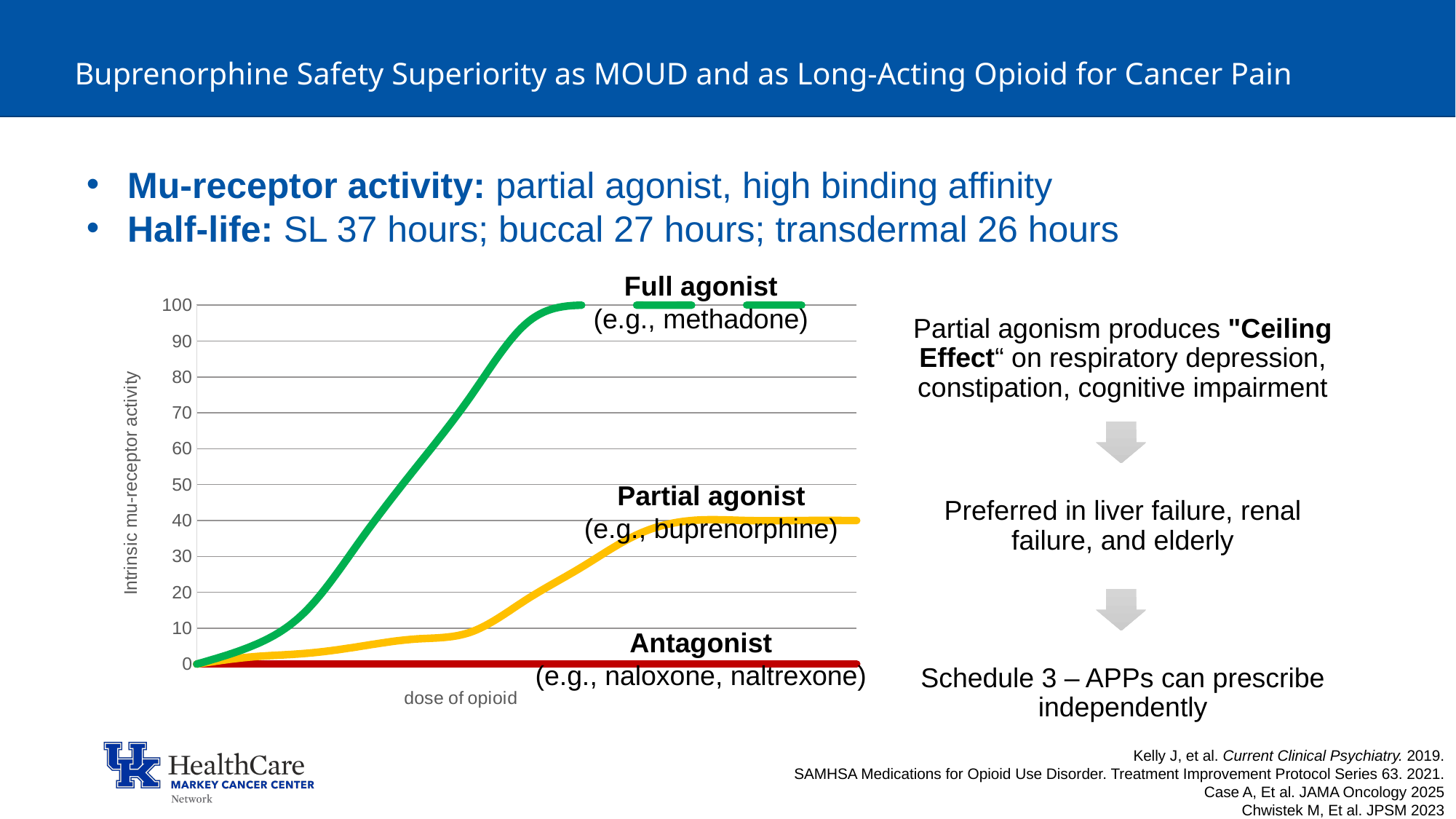
Does the Full agonist line rise or fall as the dose of opioid increases? rise Is the maximum value of the Partial agonist line greater or less than 50? less Is the maximum value of the Partial agonist line greater or less than 30? greater Which series has the lowest intrinsic mu-receptor activity across all doses? Antagonist What kind of chart is shown on the slide? line chart Does the Antagonist line rise, fall, or stay flat as the dose of opioid increases? stay flat Which series reaches the highest intrinsic mu-receptor activity? Full agonist At the highest dose shown, which line is higher: Full agonist or Partial agonist? Full agonist Is the maximum value of the Full agonist line greater or less than 90? greater How many lines (series) are plotted on the chart? 3 What colour is the Partial agonist line? yellow What is the label of the y axis? Intrinsic mu-receptor activity